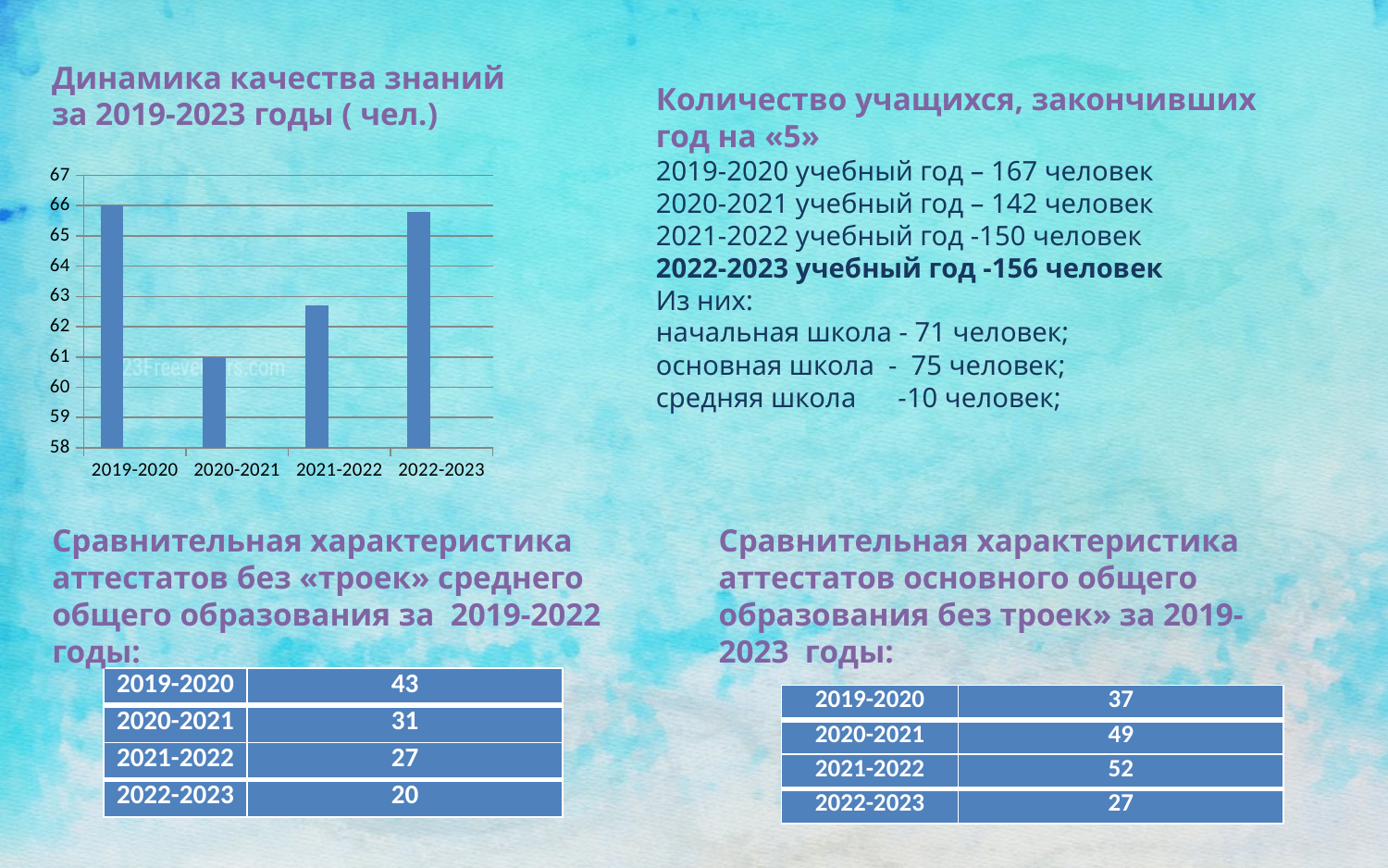
What is the difference between the values for 2019-2020 and 2020-2021 in the chart? 5 Is the value for 2021-2022 greater or less than 62? greater What is the value for 2019-2020 in the chart? 66 How many categories (school years) are shown on the x axis of the chart? 4 Does the value rise or fall from 2020-2021 to 2021-2022 in the chart? rise Which is larger in the chart, the value for 2021-2022 or the value for 2022-2023? 2022-2023 What type of chart is shown on the slide? bar chart Is the value for 2021-2022 greater or less than 63? less What is the title of the chart on the slide? Динамика качества знаний за 2019-2023 годы ( чел.) What is the value for 2020-2021 in the chart? 61 Is the value for 2022-2023 greater or less than 65? greater Which school year has the lowest value in the chart? 2020-2021